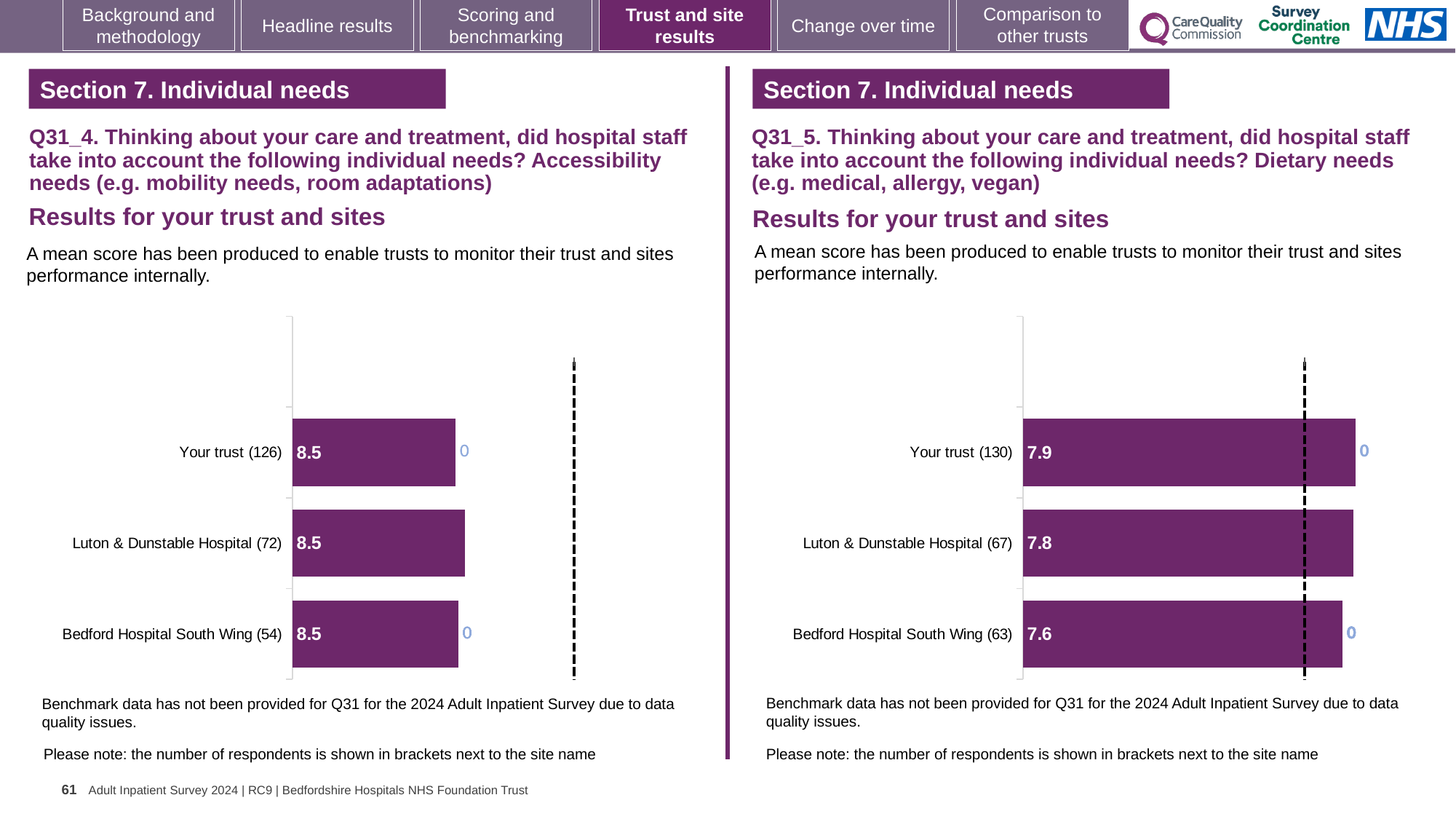
In the Q31_5 chart (Dietary needs) on the right, what is the mean score for Your trust (130)? 7.9 In the Q31_4 chart (Accessibility needs) on the left, what is the mean score for Your trust (126)? 8.5 In the Q31_5 chart (Dietary needs) on the right, what is the mean score for Bedford Hospital South Wing (63)? 7.6 In the Q31_5 chart (Dietary needs) on the right, what is the difference between the mean score for Your trust (130) and Bedford Hospital South Wing (63)? 0.3 What kind of chart is the Q31_4 chart on the left? Bar chart In the Q31_5 chart (Dietary needs) on the right, which category has the lowest mean score? Bedford Hospital South Wing (63) In the Q31_4 chart (Accessibility needs) on the left, what is the mean score for Bedford Hospital South Wing (54)? 8.5 In the Q31_5 chart (Dietary needs) on the right, which category has the highest mean score? Your trust (130) In the Q31_5 chart (Dietary needs) on the right, which has the larger mean score: Luton & Dunstable Hospital (67) or Bedford Hospital South Wing (63)? Luton & Dunstable Hospital (67) In the Q31_5 chart (Dietary needs) on the right, what is the mean score for Luton & Dunstable Hospital (67)? 7.8 In the Q31_4 chart (Accessibility needs) on the left, how many respondents are shown for Luton & Dunstable Hospital? 72 In the Q31_4 chart (Accessibility needs) on the left, how many sites or categories are plotted? 3